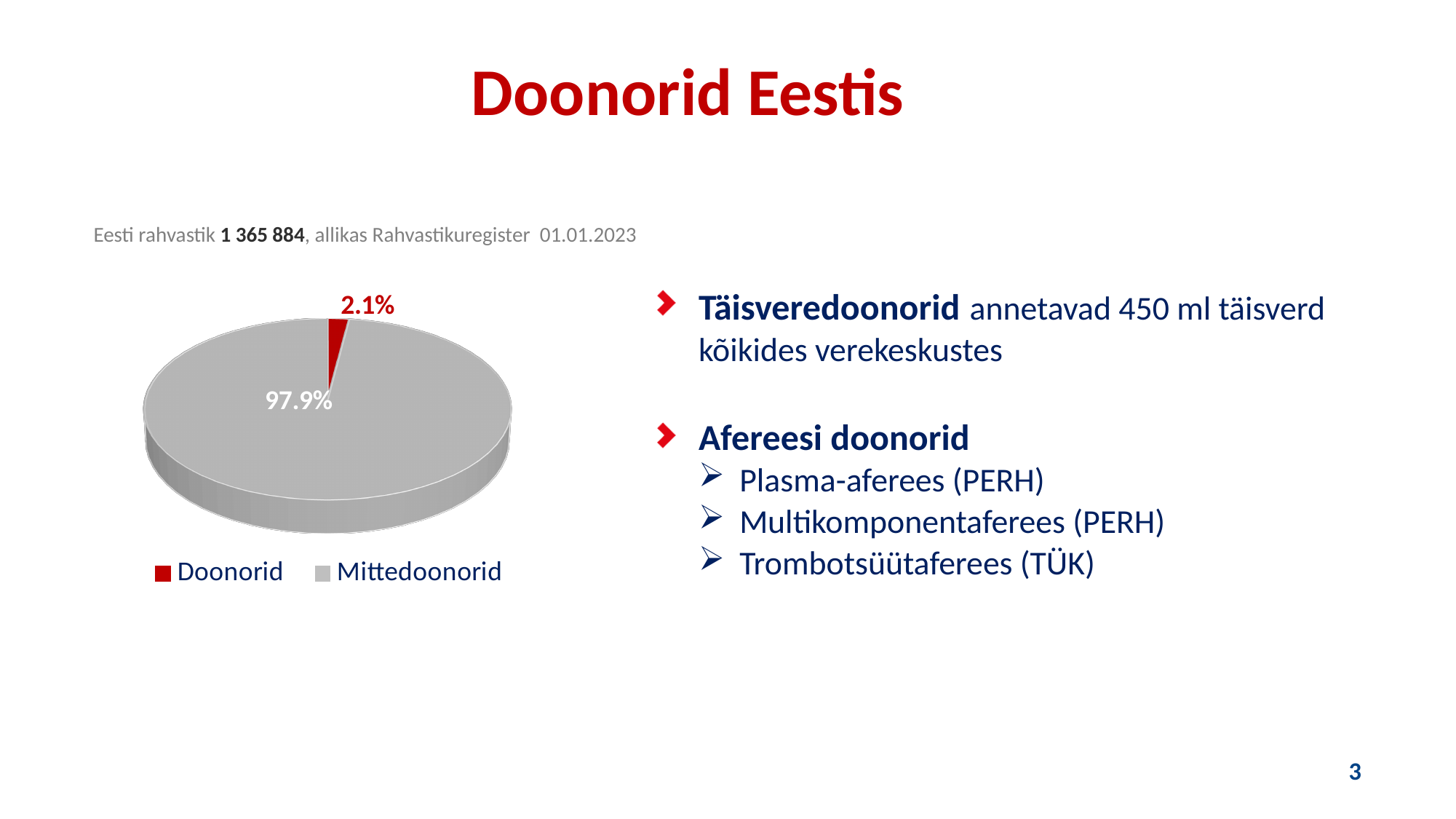
What colour is the Doonorid slice in the pie chart? red What kind of chart is shown on the slide? pie chart How many slices does the pie chart have? 2 Which slice of the pie is the smallest? Doonorid What share of the pie does Doonorid represent? 2.1% How many entries does the legend list? 2 What is the difference in percentage points between the Mittedoonorid and Doonorid slices? 95.8 What colour is the Mittedoonorid slice in the pie chart? grey Which is larger, the Doonorid slice or the Mittedoonorid slice? Mittedoonorid Which slice of the pie is the largest? Mittedoonorid What share of the pie does Mittedoonorid represent? 97.9%